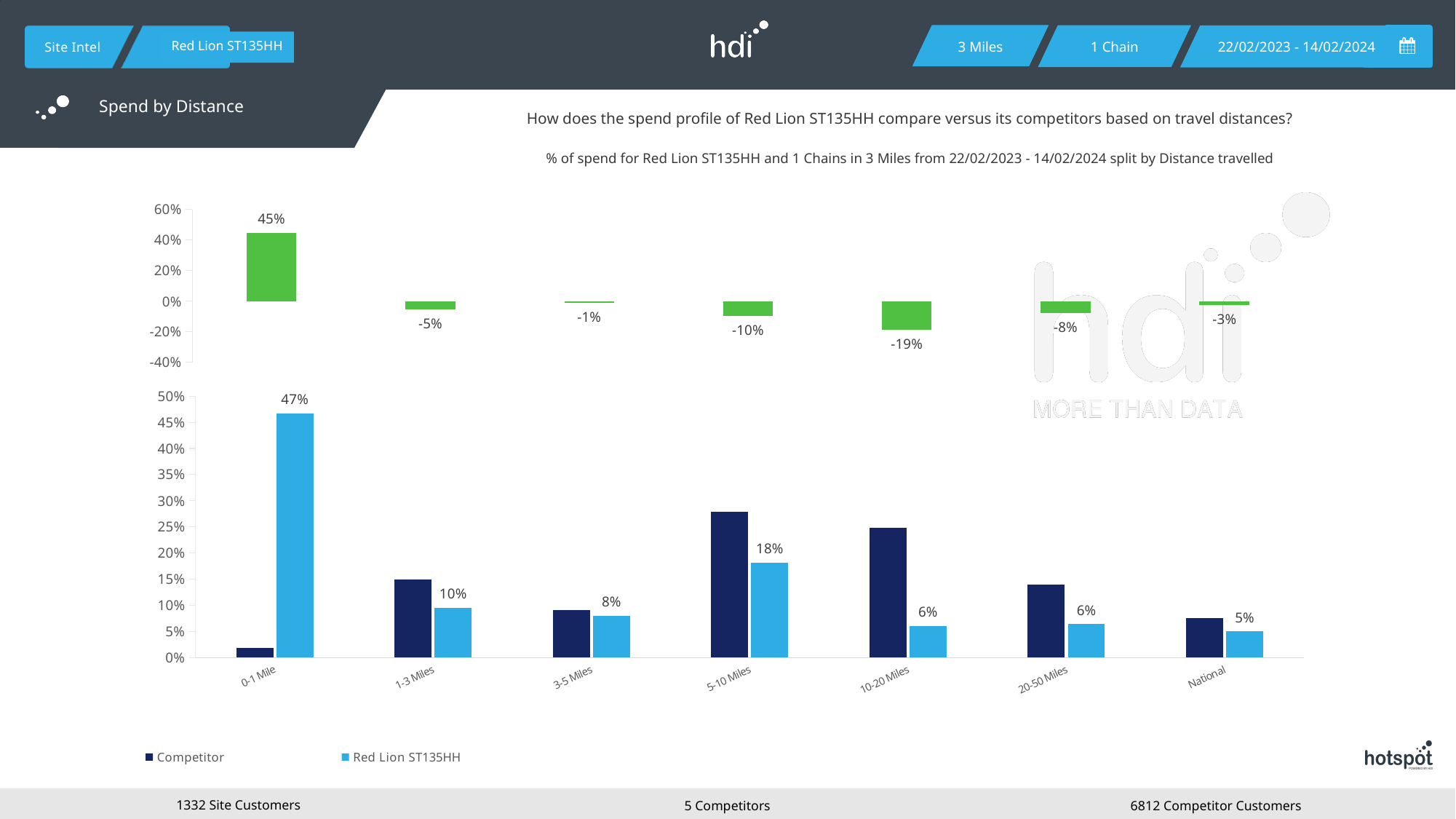
What type of chart is the bottom chart? bar chart In the bottom chart, is the Competitor value for 5-10 Miles greater or less than 25%? greater In the bottom chart, is the Competitor value for 0-1 Mile greater or less than 5%? less In the bottom chart, what is the value for Red Lion ST135HH in the 5-10 Miles category? 18% How many series does the legend of the bottom chart list? 2 In the top chart, which category has the highest value? 0-1 Mile In the top chart, what is the value shown for 10-20 Miles? -19% How many distance categories are shown on the x axis of the bottom chart? 7 In the top chart, which category has the lowest value? 10-20 Miles In the bottom chart, what is the value for Red Lion ST135HH in the 0-1 Mile category? 47% In the bottom chart, for 1-3 Miles, which series has the larger value: Competitor or Red Lion ST135HH? Competitor In the bottom chart, what is the difference between the Red Lion ST135HH values for 0-1 Mile and 5-10 Miles? 29%